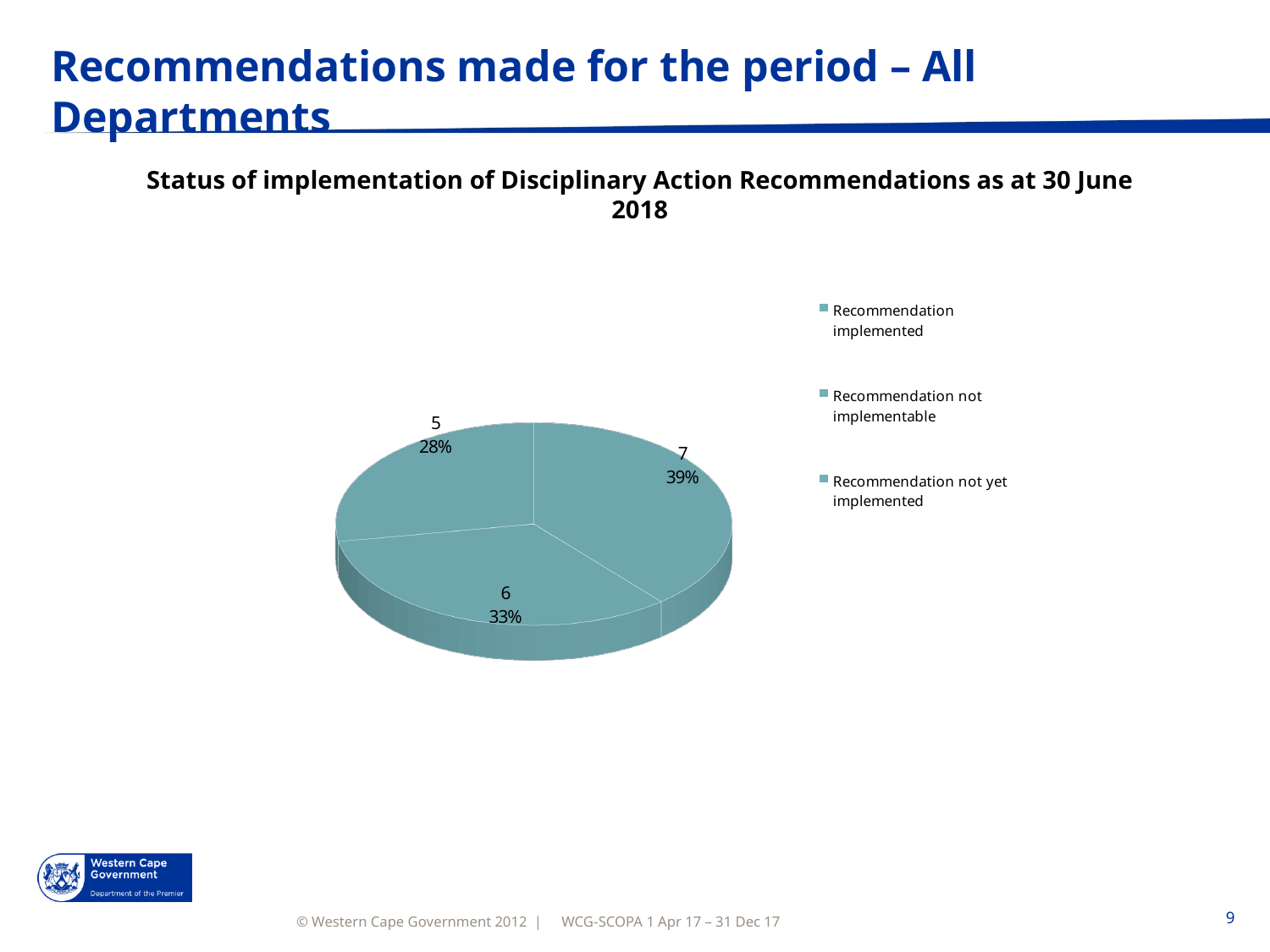
How many slices does the pie chart have? 3 What percentage share is shown for the slice with the value 5? 28% What percentage share is shown for the slice with the value 6? 33% What is the total of the three slice values in the pie chart? 18 What percentage share is shown for the slice with the value 7? 39% What is the title of the pie chart? Status of implementation of Disciplinary Action Recommendations as at 30 June 2018 What is the difference between the largest slice value (7) and the smallest slice value (5)? 2 Which is larger: the slice showing 39% or the slice showing 33%? The slice showing 39% What is the largest value shown on any slice of the pie chart? 7 What is the smallest value shown on any slice of the pie chart? 5 What kind of chart is shown on the slide? Pie chart How many entries does the legend of the pie chart list? 3